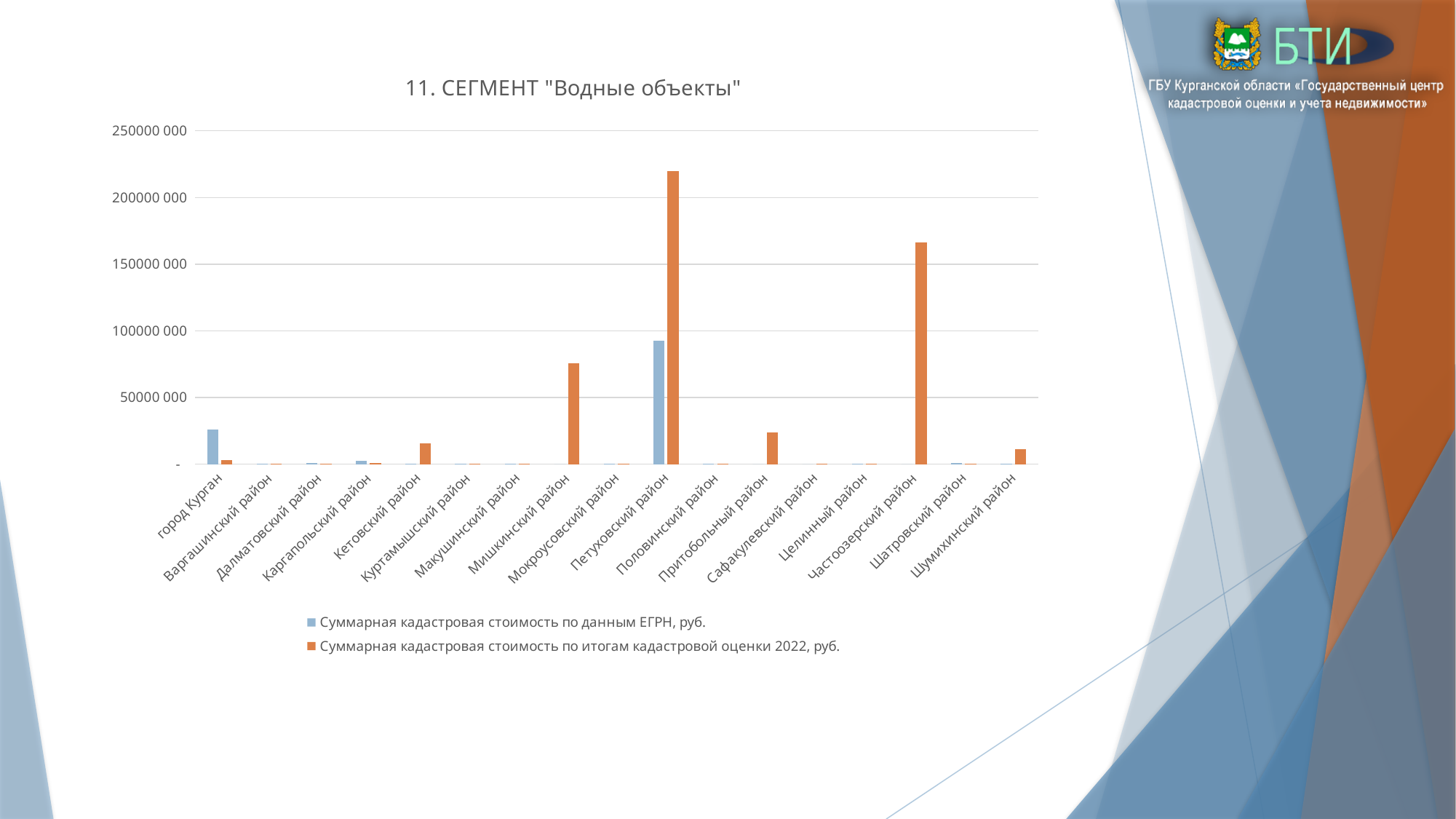
Which category has the highest value for the series "Суммарная кадастровая стоимость по итогам кадастровой оценки 2022, руб."? Петуховский район Which colour represents the series "Суммарная кадастровая стоимость по данным ЕГРН, руб."? blue What is the title of the chart? 11. СЕГМЕНТ "Водные объекты" Is the value for Петуховский район in the series "Суммарная кадастровая стоимость по итогам кадастровой оценки 2022, руб." greater or less than 200000 000? greater What kind of chart is shown on the slide? bar chart How many categories are shown on the x axis? 17 Which is larger for the series "Суммарная кадастровая стоимость по итогам кадастровой оценки 2022, руб.": Частоозерский район or Мишкинский район? Частоозерский район Is the value for Частоозерский район in the series "Суммарная кадастровая стоимость по итогам кадастровой оценки 2022, руб." greater or less than 150000 000? greater Is the value for Мишкинский район in the series "Суммарная кадастровая стоимость по итогам кадастровой оценки 2022, руб." greater or less than 100000 000? less For Петуховский район, which series has the larger value: "Суммарная кадастровая стоимость по данным ЕГРН, руб." or "Суммарная кадастровая стоимость по итогам кадастровой оценки 2022, руб."? Суммарная кадастровая стоимость по итогам кадастровой оценки 2022, руб. How many series does the legend list? 2 Which category has the highest value for the series "Суммарная кадастровая стоимость по данным ЕГРН, руб."? Петуховский район